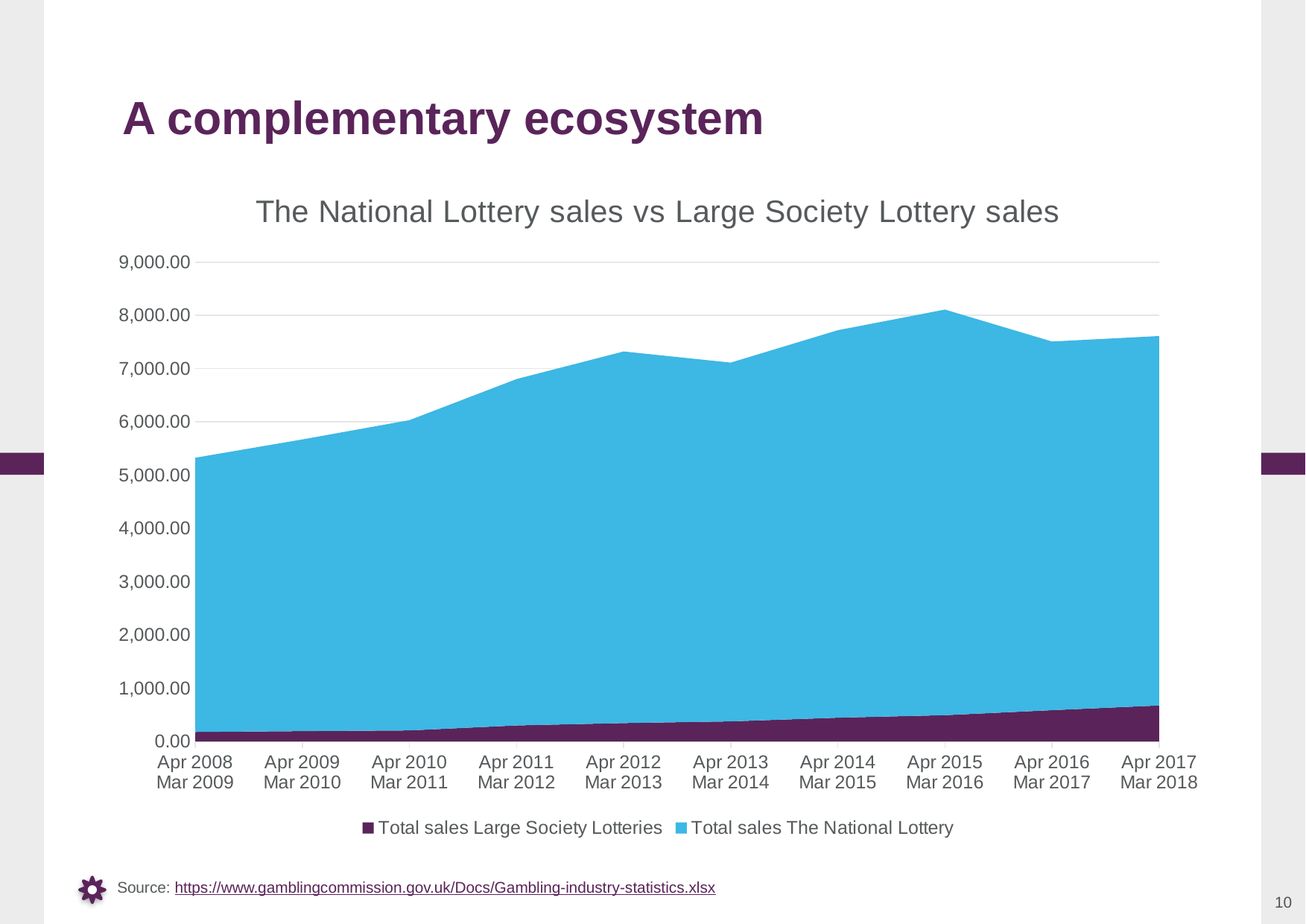
Is the value for Total sales Large Society Lotteries in Apr 2017 Mar 2018 greater or less than 1,000.00? less Which series has the larger sales values throughout the chart? Total sales The National Lottery How many series does the legend list? 2 Do the Total sales Large Society Lotteries values rise or fall from Apr 2008 Mar 2009 to Apr 2017 Mar 2018? rise Which series is shown in dark purple? Total sales Large Society Lotteries Is the combined stacked total for Apr 2008 Mar 2009 greater or less than 5,000.00? greater In which period is the combined stacked total lowest? Apr 2008 Mar 2009 What kind of chart is shown on the slide? Stacked area chart Is the combined stacked total for Apr 2017 Mar 2018 greater or less than 8,000.00? less How many time periods are shown along the x axis? 10 What is the title of the chart? The National Lottery sales vs Large Society Lottery sales In which period is the combined stacked total highest? Apr 2015 Mar 2016